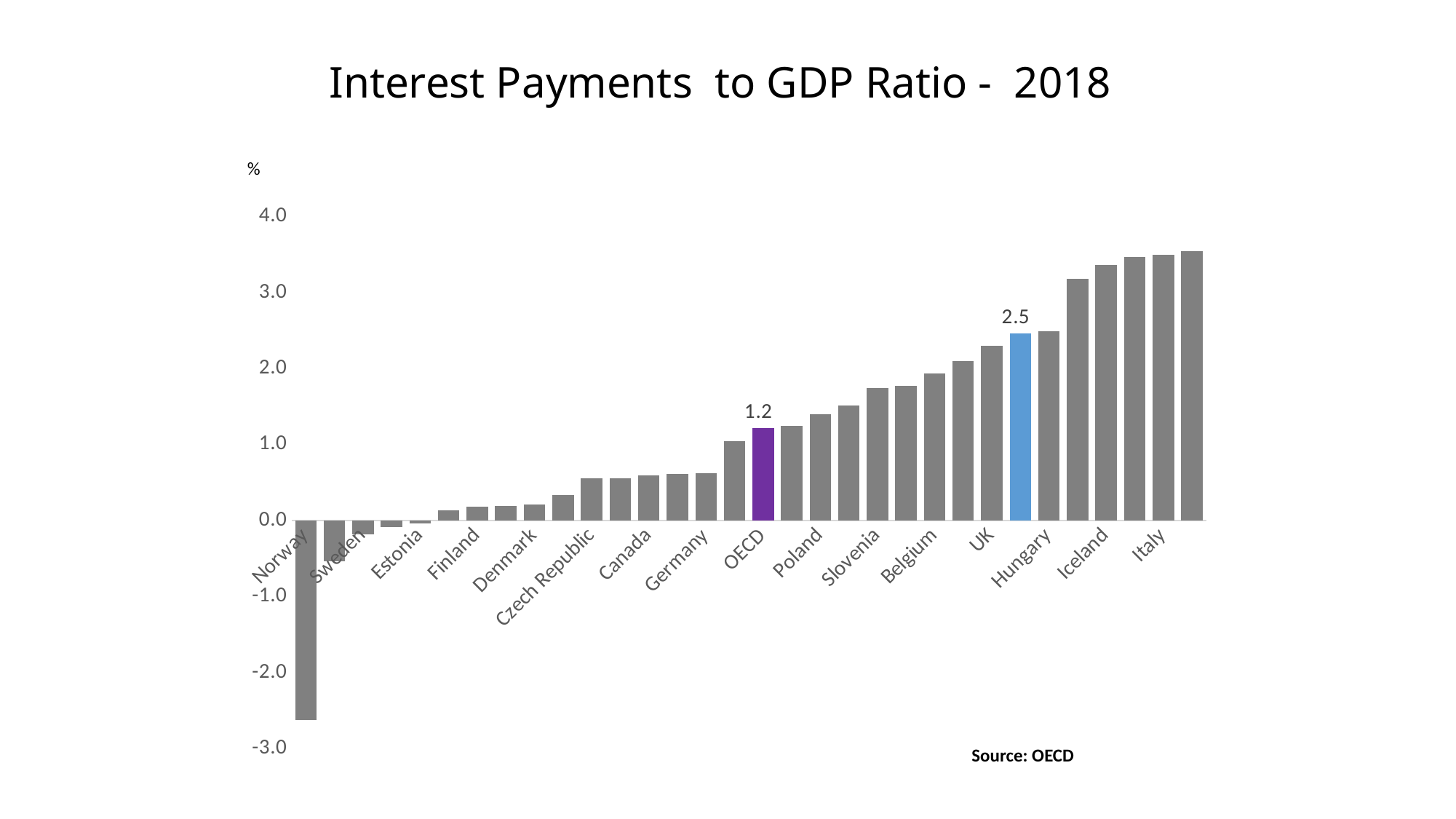
What is the title of the chart? Interest Payments to GDP Ratio - 2018 Which has the larger value, Norway or Sweden? Sweden Is the value for Norway greater or less than -2.0? less Is the value for Belgium greater or less than 1.0? greater Is the value for Germany greater or less than 1.0? less What value is printed above the blue bar? 2.5 Which has the larger value, Italy or Poland? Italy What kind of chart is shown on the slide? bar chart What is the value for OECD? 1.2 Do the values generally rise or fall from left to right along the x axis? rise